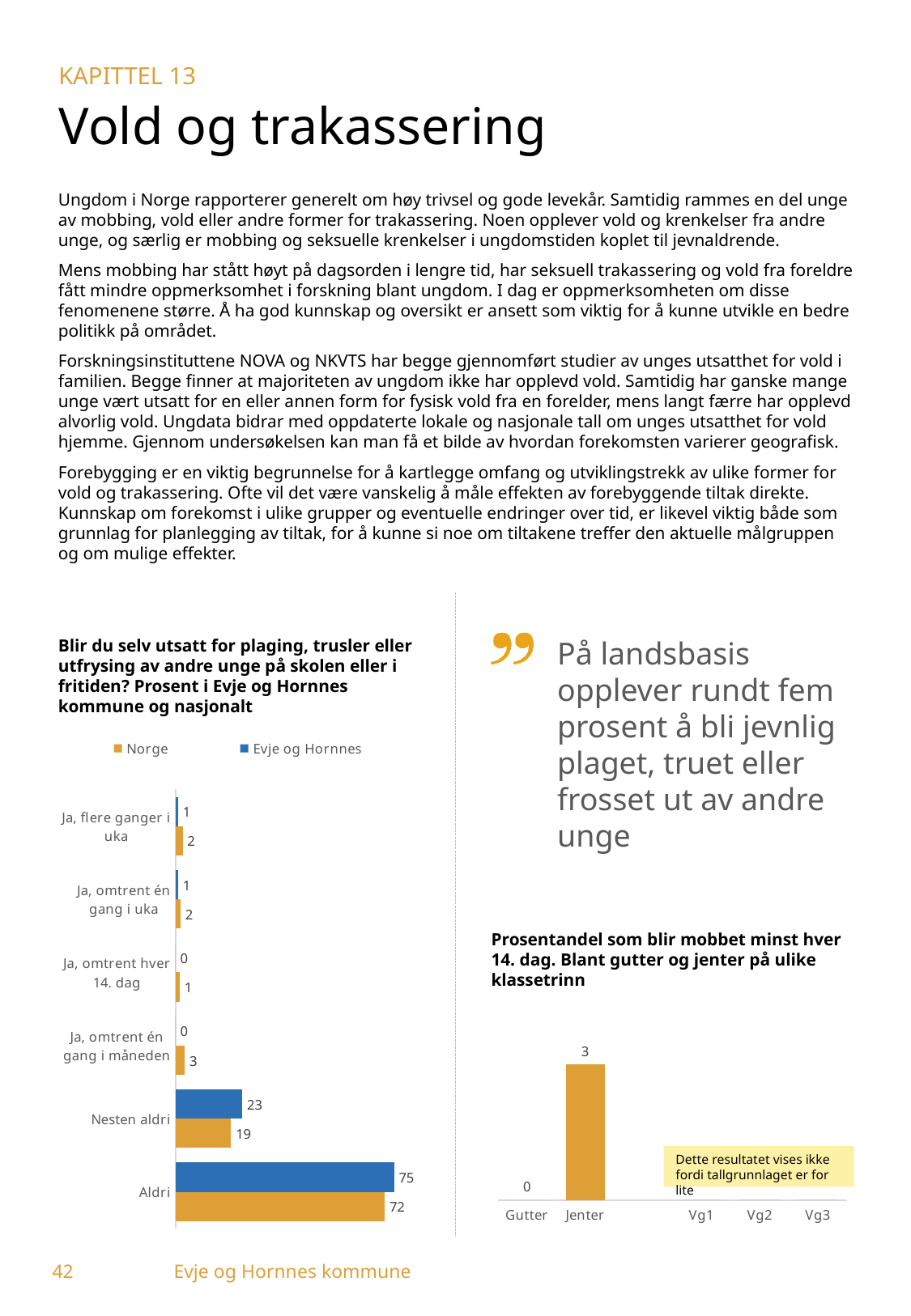
In the chart 'Blir du selv utsatt for plaging, trusler eller utfrysing av andre unge på skolen eller i fritiden?', what is the value for Norge for 'Ja, omtrent én gang i måneden'? 3 In the chart 'Blir du selv utsatt for plaging, trusler eller utfrysing av andre unge på skolen eller i fritiden?', what is the value for Evje og Hornnes for 'Aldri'? 75 In the chart 'Prosentandel som blir mobbet minst hver 14. dag', what is the value for Jenter? 3 In the chart 'Blir du selv utsatt for plaging, trusler eller utfrysing av andre unge på skolen eller i fritiden?', which category has the highest value for Evje og Hornnes? Aldri In the chart 'Blir du selv utsatt for plaging, trusler eller utfrysing av andre unge på skolen eller i fritiden?', which colour represents Norge? Orange In the chart 'Blir du selv utsatt for plaging, trusler eller utfrysing av andre unge på skolen eller i fritiden?', how many categories are shown? 6 In the chart 'Blir du selv utsatt for plaging, trusler eller utfrysing av andre unge på skolen eller i fritiden?', what is the difference between Evje og Hornnes and Norge for 'Nesten aldri'? 4 In the chart 'Prosentandel som blir mobbet minst hver 14. dag', what is the value for Gutter? 0 In the chart 'Blir du selv utsatt for plaging, trusler eller utfrysing av andre unge på skolen eller i fritiden?', how many series does the legend list? 2 In the chart 'Blir du selv utsatt for plaging, trusler eller utfrysing av andre unge på skolen eller i fritiden?', what is the value for Norge for 'Nesten aldri'? 19 In the chart 'Blir du selv utsatt for plaging, trusler eller utfrysing av andre unge på skolen eller i fritiden?', which is larger for 'Aldri': Norge or Evje og Hornnes? Evje og Hornnes What kind of chart is 'Blir du selv utsatt for plaging, trusler eller utfrysing av andre unge på skolen eller i fritiden?'? Bar chart